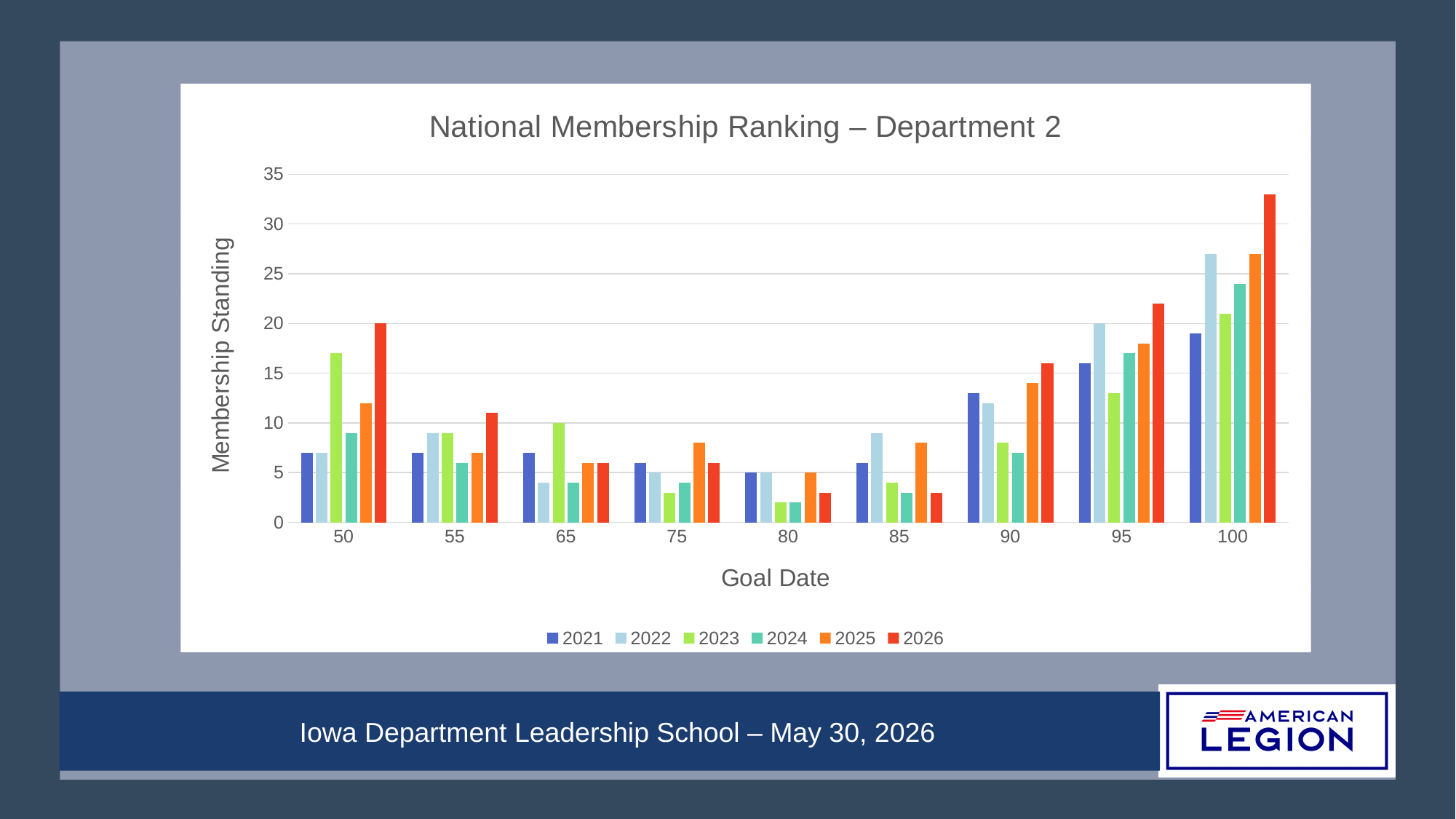
How many goal date categories are shown on the x axis? 9 What kind of chart is shown on the slide? bar chart What is the membership standing for 2023 at goal date 65? 10 Which is larger at goal date 90: the value for 2021 or the value for 2023? 2021 Which year has the highest membership standing at goal date 100? 2026 Is the value for 2026 at goal date 100 greater or less than 30? greater What is the label of the x axis? Goal Date Which year has the highest membership standing at goal date 65? 2023 Is the value for 2024 at goal date 80 greater or less than 5? less What is the membership standing for 2026 at goal date 50? 20 What is the membership standing for 2022 at goal date 95? 20 How many series does the legend list? 6